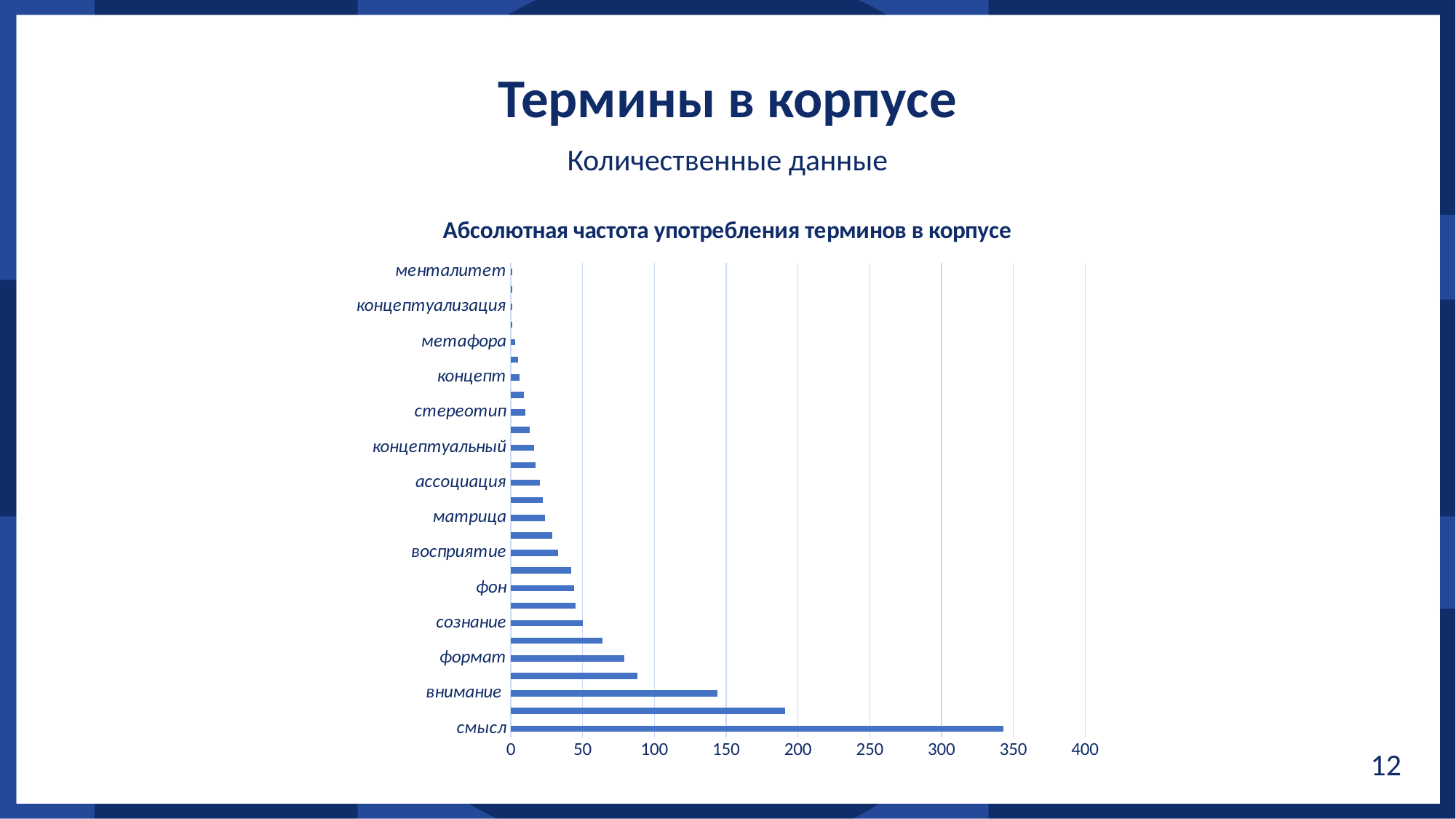
Which has a higher frequency, формат or фон? формат Which has a higher frequency, смысл or внимание? смысл Which term has the highest frequency in the chart? смысл Is the value for формат greater or less than 50? greater Is the value for смысл greater or less than 300? greater What is the title of the chart? Абсолютная частота употребления терминов в корпусе Is the value for фон greater or less than 50? less What kind of chart is shown on the slide? bar chart What is the highest value shown on the horizontal axis? 400